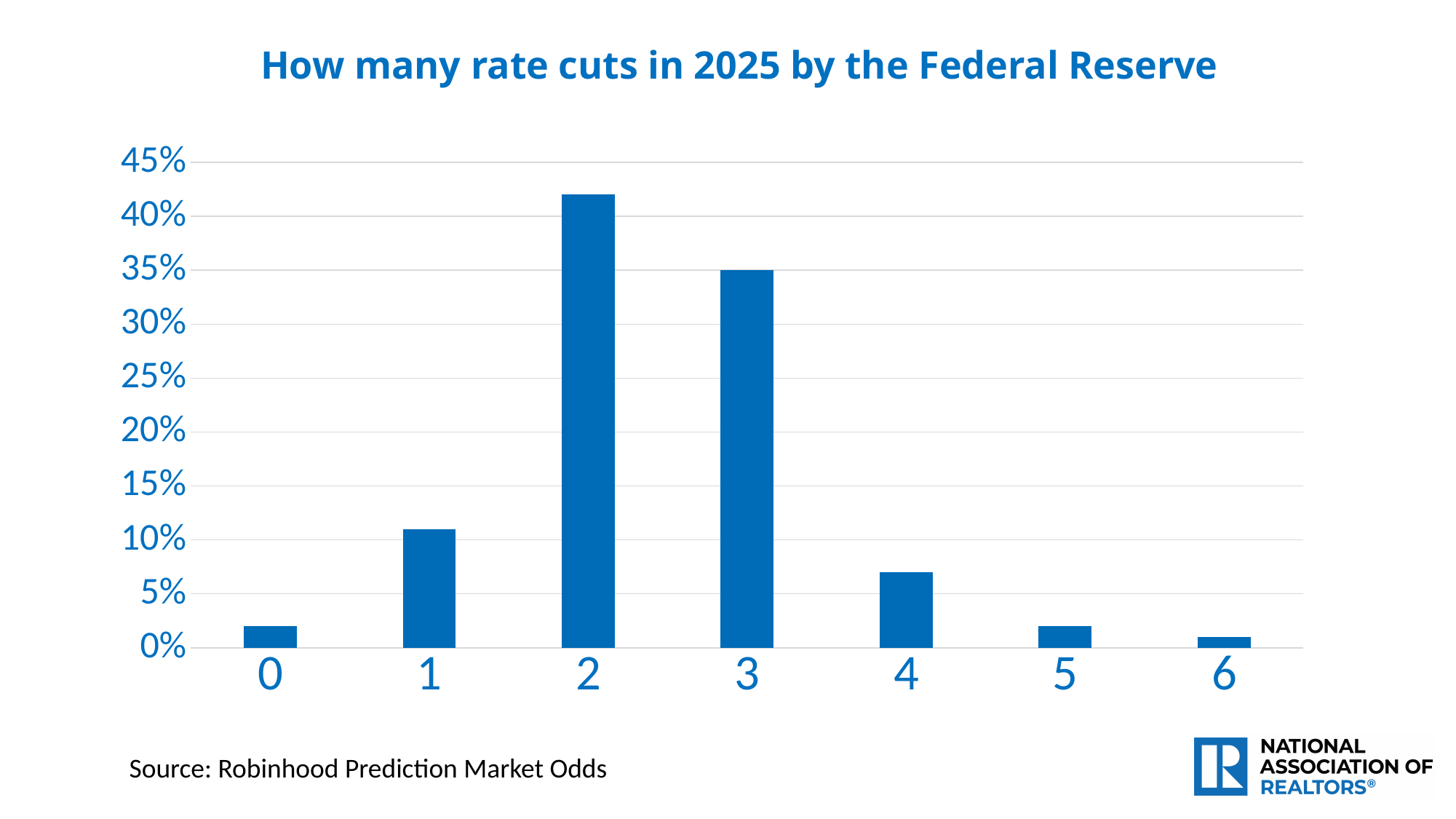
What is the probability shown for 3 rate cuts? 35% Is the value for 4 rate cuts greater or less than 5%? greater What is the title of the chart? How many rate cuts in 2025 by the Federal Reserve What type of chart is shown on the slide? Bar chart From 3 rate cuts to 6 rate cuts, do the values rise or fall? fall Is the value for 0 rate cuts greater or less than 5%? less Is the value for 1 rate cut greater or less than 10%? greater Which has a higher probability, 1 rate cut or 4 rate cuts? 1 rate cut How many categories (numbers of rate cuts) are shown on the x axis? 7 Which number of rate cuts has the highest probability? 2 Which has a higher probability, 2 rate cuts or 3 rate cuts? 2 rate cuts